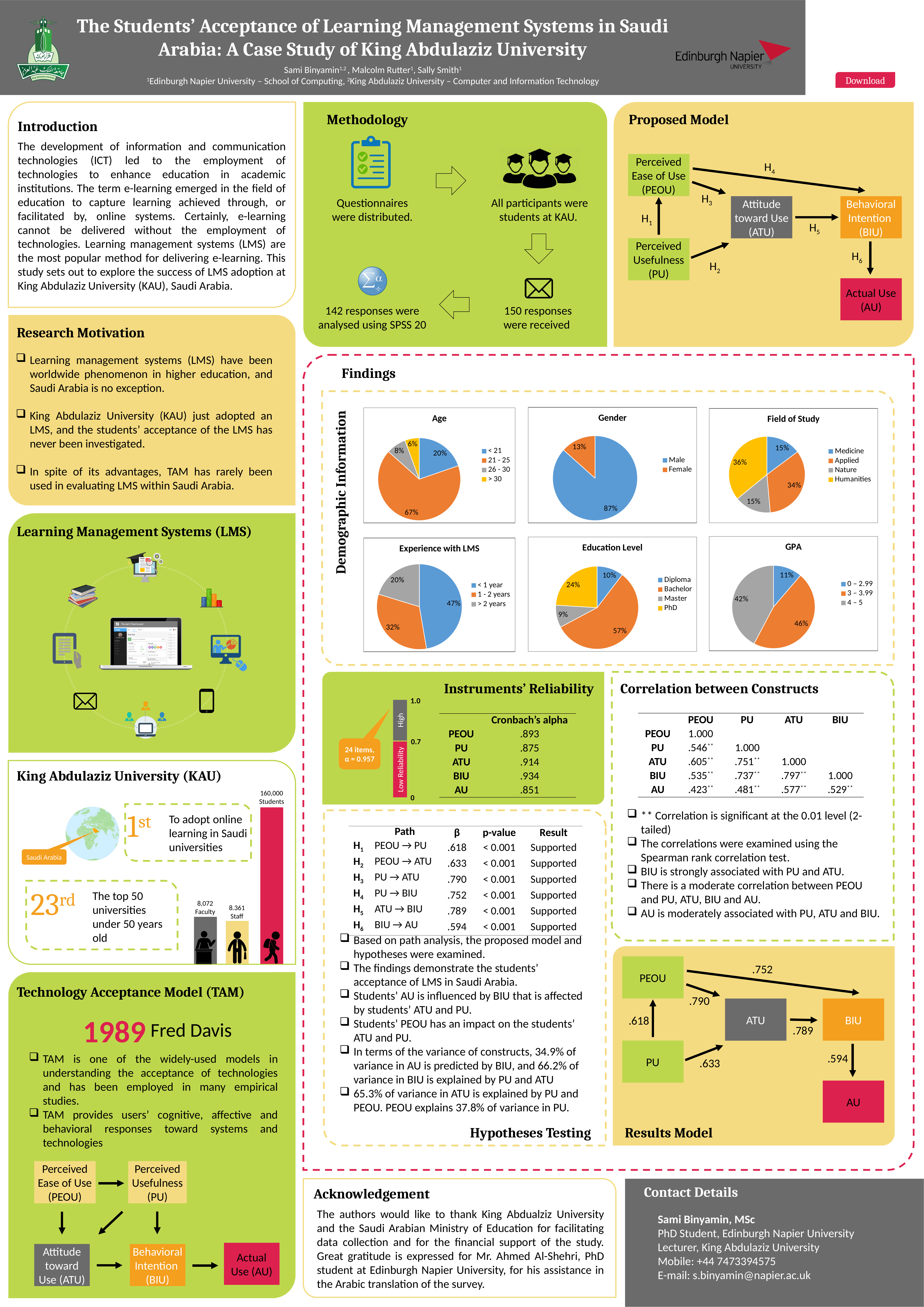
In the Education Level pie chart, what share of respondents hold a Bachelor degree? 57% In the Age pie chart, what share of respondents are aged 21 - 25? 67% In the Field of Study pie chart, which field has the largest share? Humanities In the Gender pie chart, what is the difference between the Male and Female shares? 74% In the King Abdulaziz University bar chart, what is the value for Staff? 8,361 In the Age pie chart, which age group has the smallest share? > 30 In the GPA pie chart, what is the share for the 3 – 3.99 group? 46% What kind of chart is used for the Demographic Information section? Pie chart In the Gender pie chart, what percentage of respondents are Female? 13% In the Field of Study pie chart, how many categories does the legend list? 4 In the Experience with LMS pie chart, what share of respondents have less than 1 year of experience? 47% In the Experience with LMS pie chart, which is larger: 1 - 2 years or > 2 years? 1 - 2 years